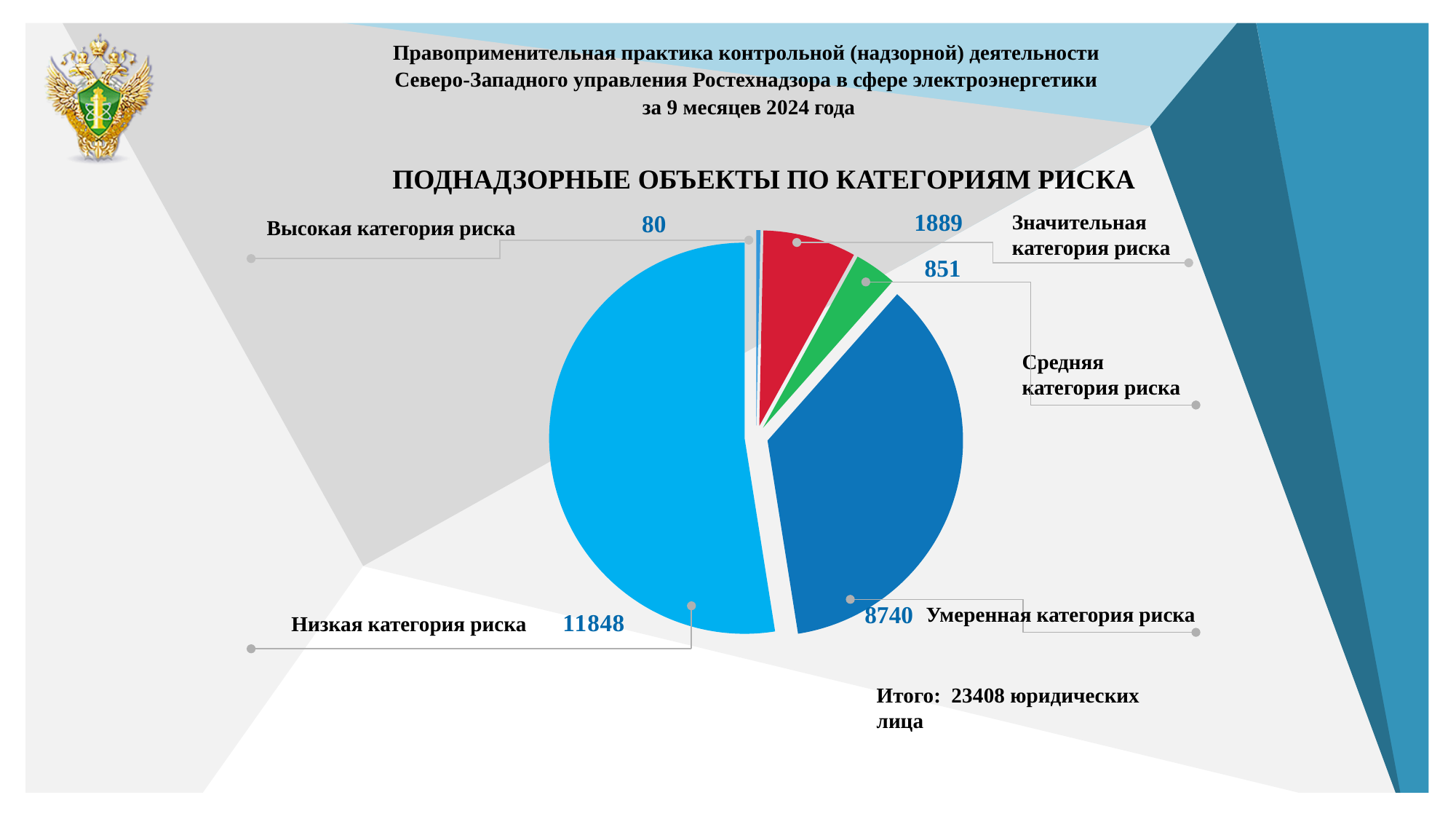
What is the total number of objects across all categories, as stated on the slide? 23408 Which category has the smallest value? Высокая категория риска Which is larger, Значительная категория риска or Средняя категория риска? Значительная категория риска What kind of chart is shown on the slide? Pie chart How many categories does the pie chart show? 5 What is the value for Умеренная категория риска? 8740 What is the value for Высокая категория риска? 80 What is the value for Низкая категория риска? 11848 What is the value for Средняя категория риска? 851 What is the value for Значительная категория риска? 1889 What is the difference between Низкая категория риска and Умеренная категория риска? 3108 Which category has the largest value? Низкая категория риска